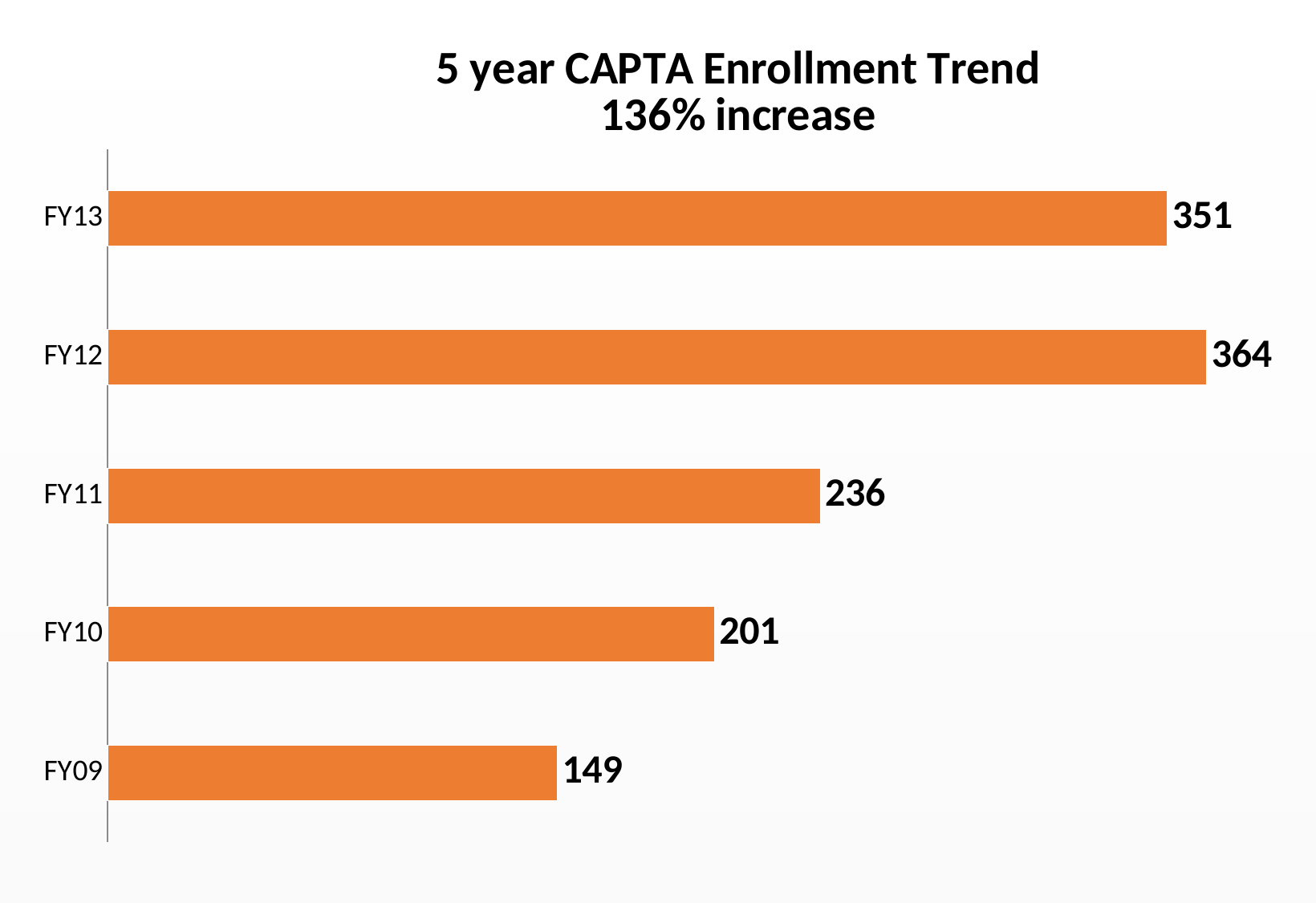
What is the enrollment value for FY09? 149 Which fiscal year has the highest enrollment? FY12 What is the enrollment value for FY13? 351 Which is larger, the enrollment for FY11 or FY10? FY11 What is the difference between the FY12 and FY13 enrollment values? 13 Which fiscal year has the lowest enrollment? FY09 What kind of chart is shown on the slide? Bar chart What is the difference between the FY10 and FY09 enrollment values? 52 What is the title of the chart? 5 year CAPTA Enrollment Trend 136% increase What is the enrollment value for FY11? 236 What colour are the bars in the chart? Orange How many fiscal years are shown in the chart? 5